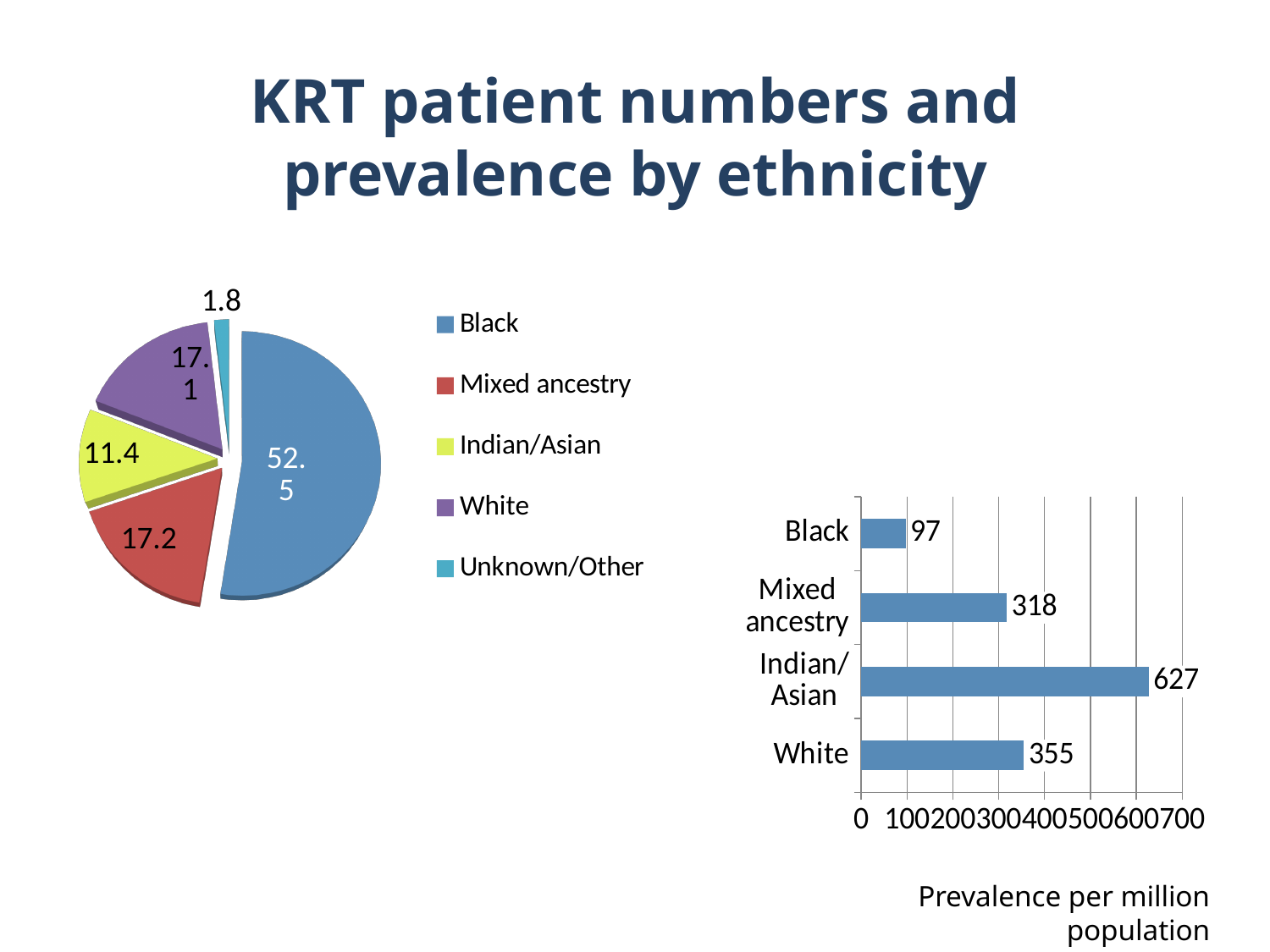
How many entries does the legend of the pie chart on the left list? 5 In the bar chart on the right, which category has the highest prevalence per million population? Indian/Asian In the bar chart on the right, what is the prevalence per million population for Indian/Asian? 627 In the bar chart on the right, what is the prevalence per million population for Black? 97 In the pie chart on the left, what is the value shown for the Indian/Asian slice? 11.4 In the bar chart on the right, what is the difference between the White value and the Mixed ancestry value? 37 In the pie chart on the left, which category has the largest slice? Black In the pie chart on the left, which category has the smallest slice? Unknown/Other In the bar chart on the right, which category has the lowest prevalence per million population? Black In the pie chart on the left, what is the difference between the Mixed ancestry value and the White value? 0.1 What kind of chart is shown on the right of the slide? Bar chart In the pie chart on the left, what is the value shown for the Black slice? 52.5